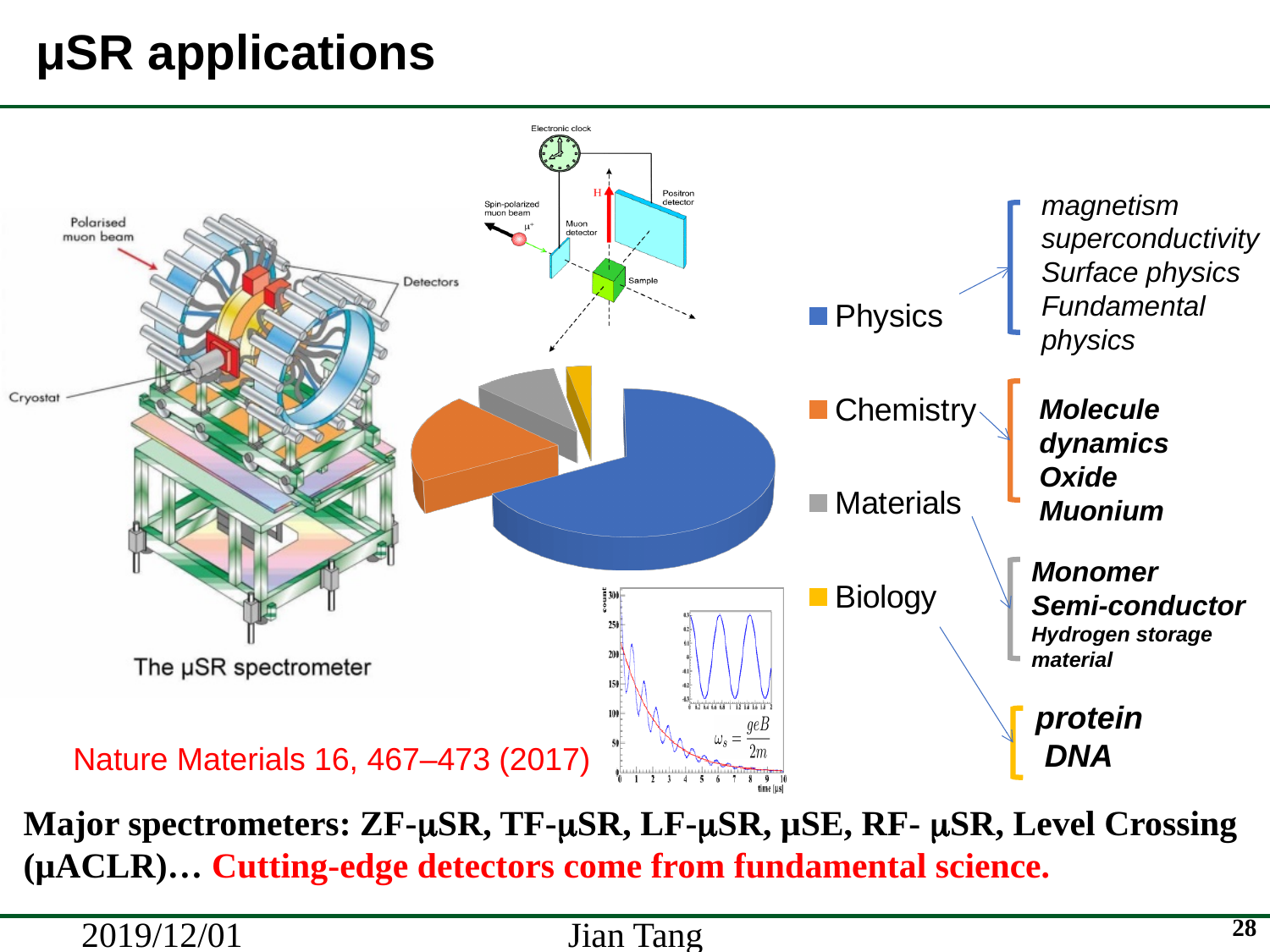
In the pie chart, which slice is larger, Physics or Chemistry? Physics Which category has the largest slice in the pie chart? Physics How many entries does the pie chart's legend list? 4 What colour represents Physics in the pie chart? blue In the pie chart, which slice is larger, Chemistry or Materials? Chemistry Which category has the smallest slice in the pie chart? Biology In the pie chart, which slice is larger, Materials or Biology? Materials Which category is shown in orange in the pie chart? Chemistry How many categories does the pie chart show? 4 What kind of chart is used to show the μSR application areas? pie chart